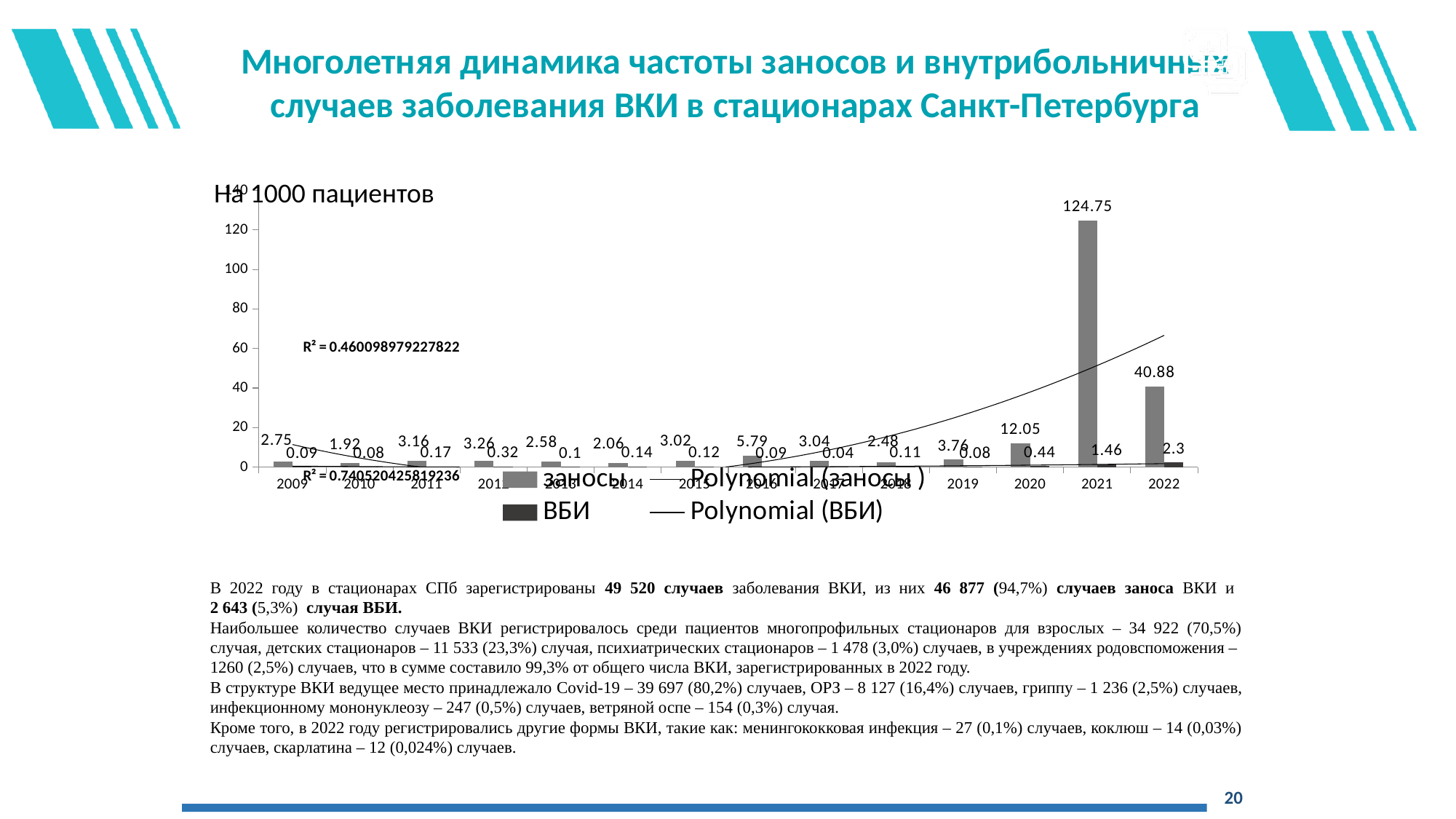
In which year is the value for заносы highest? 2021 What is the value for ВБИ in 2022? 2.3 What is the value for заносы in 2021? 124.75 What kind of chart is shown on the slide? bar chart How many entries does the legend list? 4 What unit label is shown above the vertical axis of the chart? На 1000 пациентов Is the value for заносы in 2021 greater or less than 100? greater What is the difference between the заносы values for 2021 and 2022? 83.87 Which year has the larger value for заносы, 2019 or 2020? 2020 How many years are shown on the x axis? 14 What is the value for заносы in 2016? 5.79 In which year is the value for ВБИ lowest? 2017